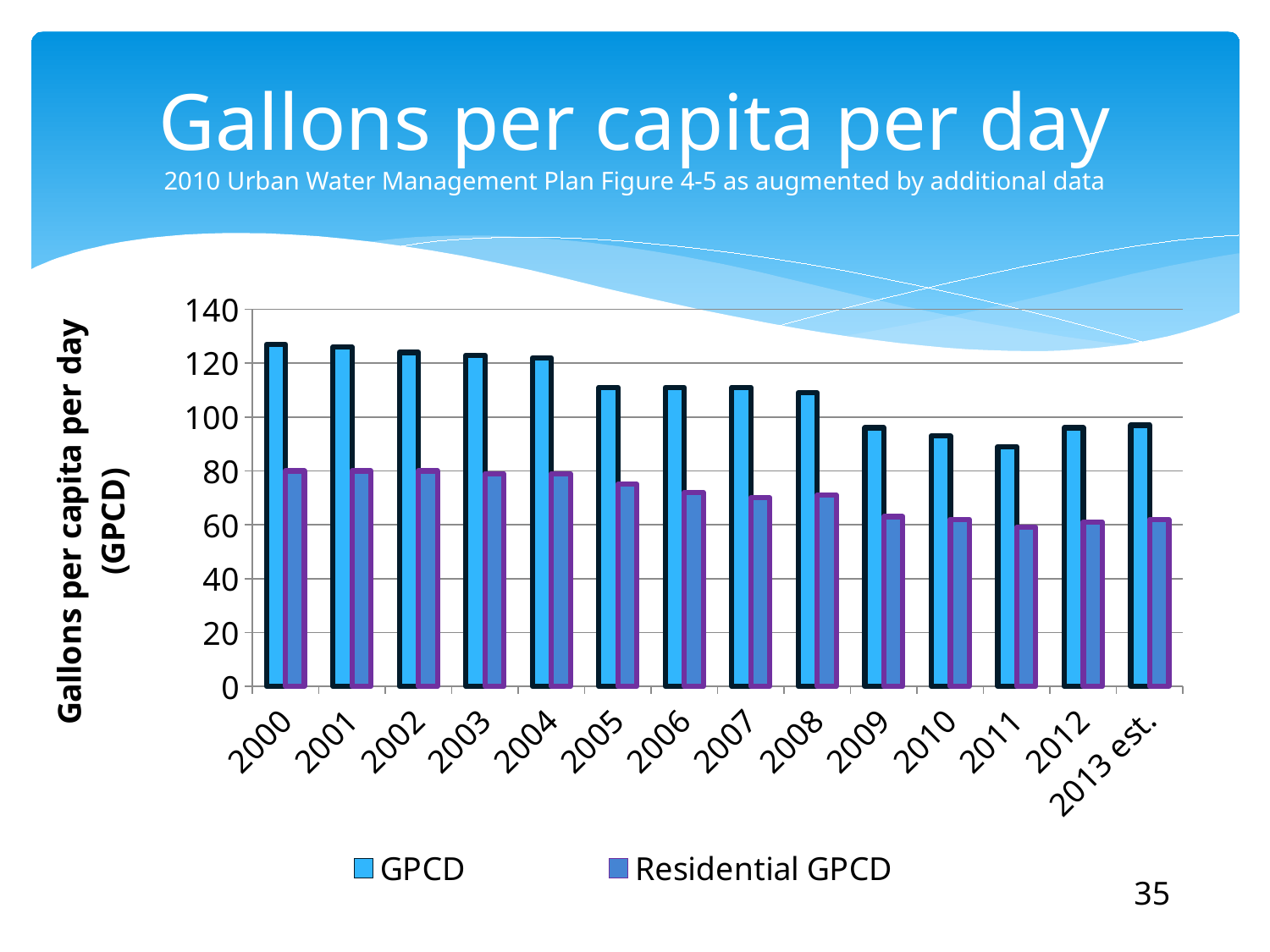
What is the label on the vertical axis? Gallons per capita per day (GPCD) How many series does the legend list? 2 Do the GPCD values generally rise or fall from 2000 to 2011? fall How many years (categories) are shown on the x axis? 14 Is the GPCD value for 2011 greater or less than 100? less Which is larger, the Residential GPCD value for 2000 or for 2009? 2000 Which is larger, the GPCD value for 2000 or for 2011? 2000 Is the GPCD value for 2000 greater or less than 120? greater What kind of chart is shown on the slide? bar chart Which year has the lowest GPCD value? 2011 Is the GPCD value for 2005 greater or less than 100? greater